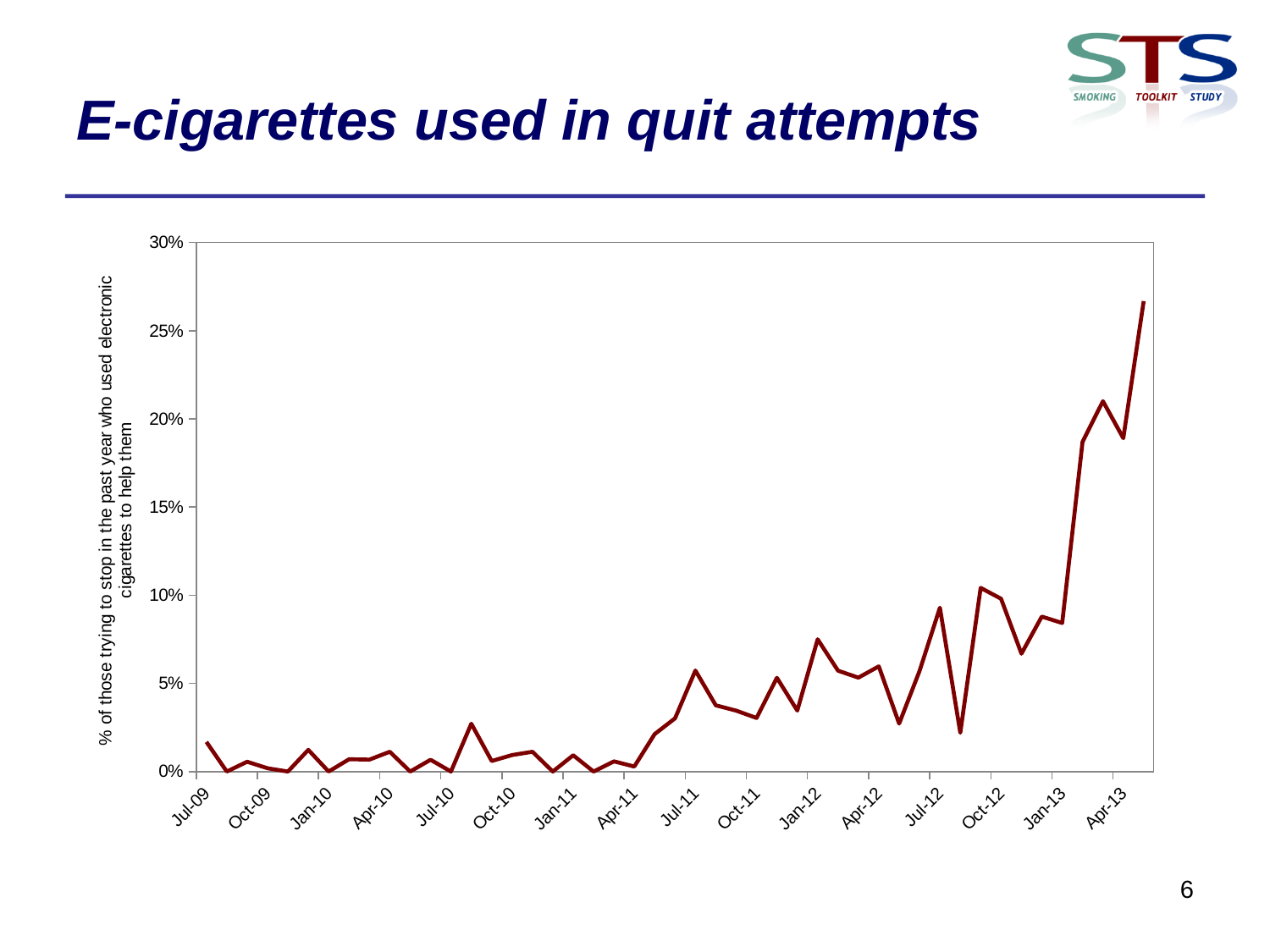
Do the values generally rise or fall from Jul-09 to Apr-13? rise What is the highest value shown on the y axis? 30% Which has the larger value, Jan-10 or Jan-13? Jan-13 Is the value for Jan-13 greater or less than 15%? less Is the value for Jan-12 greater or less than 5%? greater Is the value for Jul-12 greater or less than 5%? greater What kind of chart is shown on the slide? line chart Which has the larger value, Jul-09 or Apr-13? Apr-13 How many month labels are shown on the x axis? 16